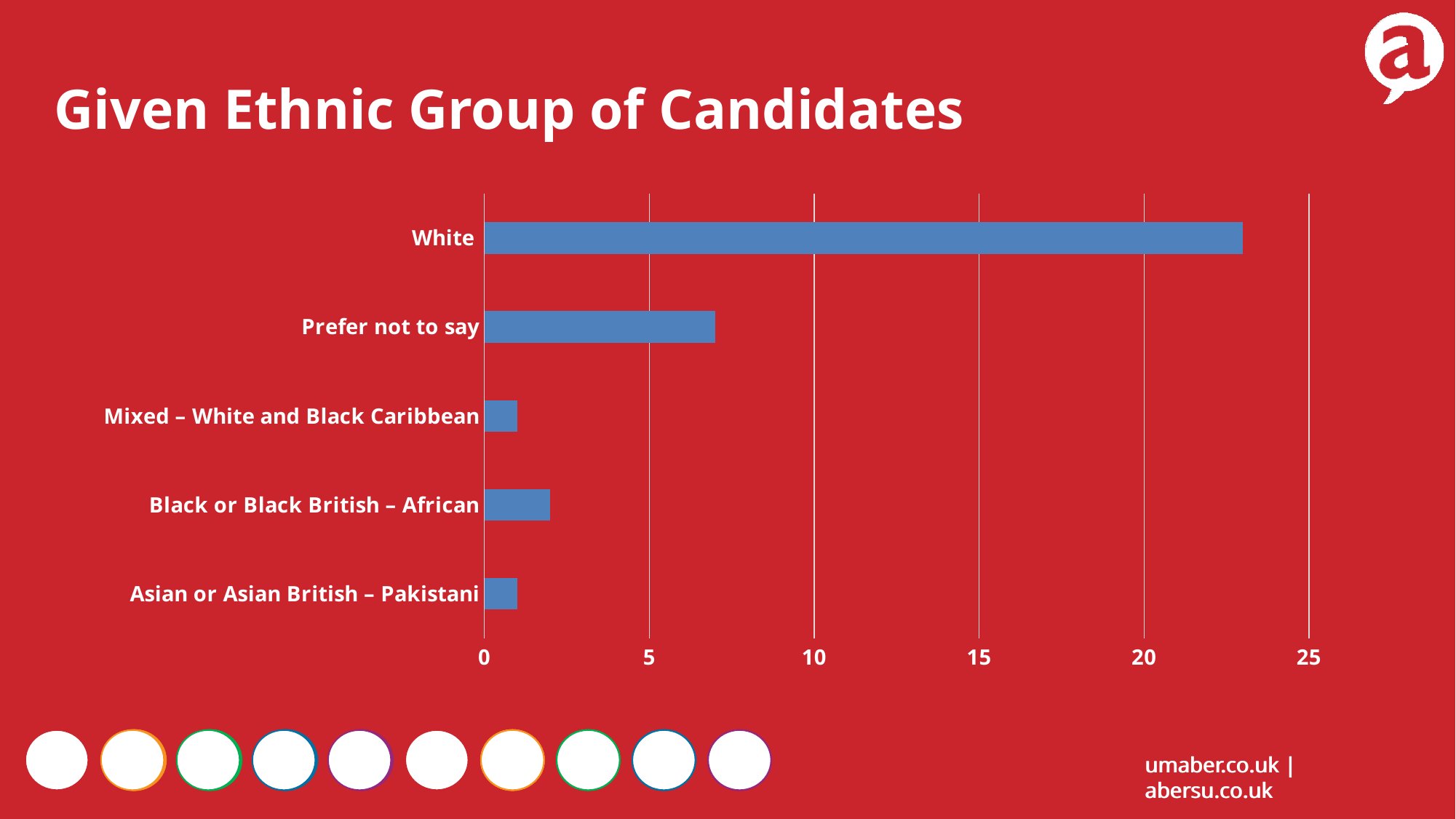
Which category has the highest value? White How many ethnic group categories are shown in the chart? 5 What type of chart is shown on the slide? bar chart Which is larger, the value for White or the value for Prefer not to say? White What is the highest value shown on the horizontal axis? 25 Is the value for Prefer not to say greater or less than 10? less Is the value for White greater or less than 25? less Is the value for Black or Black British – African greater or less than 5? less What is the title of the chart? Given Ethnic Group of Candidates Which is larger, the value for Black or Black British – African or the value for Mixed – White and Black Caribbean? Black or Black British – African